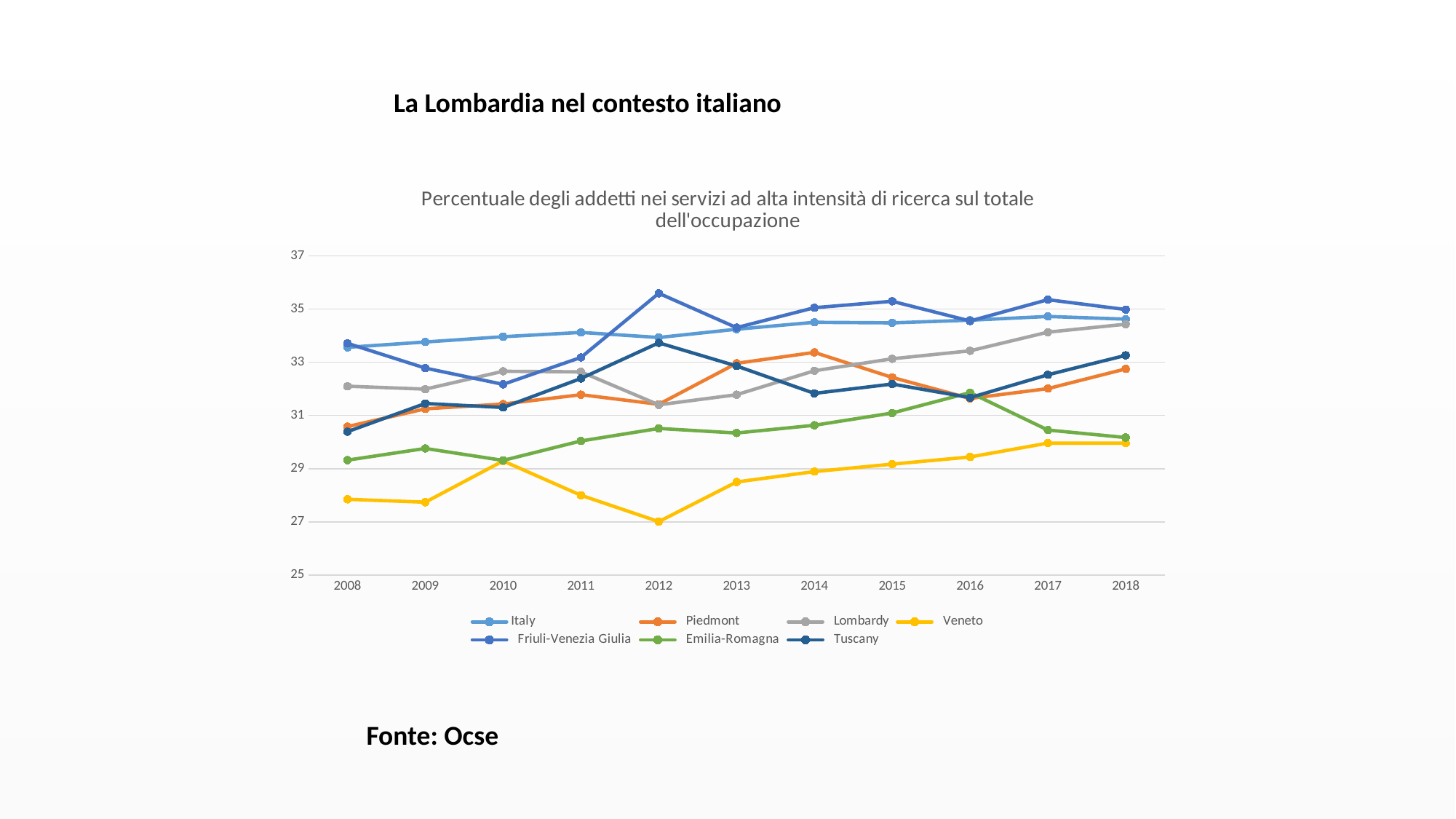
How many years are shown on the x axis? 11 What kind of chart is shown on the slide? line chart Which series has the highest value in 2012? Friuli-Venezia Giulia Is the value for Tuscany in 2012 greater or less than 33? greater Is the value for Friuli-Venezia Giulia in 2012 greater or less than 35? greater What colour is the Veneto line in the legend? yellow Is the value for Veneto in 2008 greater or less than 29? less How many series does the legend list? 7 Which series has the lowest value in 2012? Veneto Does the Veneto line rise or fall from 2012 to 2018? rise Which is larger in 2018, the value for Piedmont or the value for Emilia-Romagna? Piedmont Which is larger in 2008, the value for Italy or the value for Tuscany? Italy